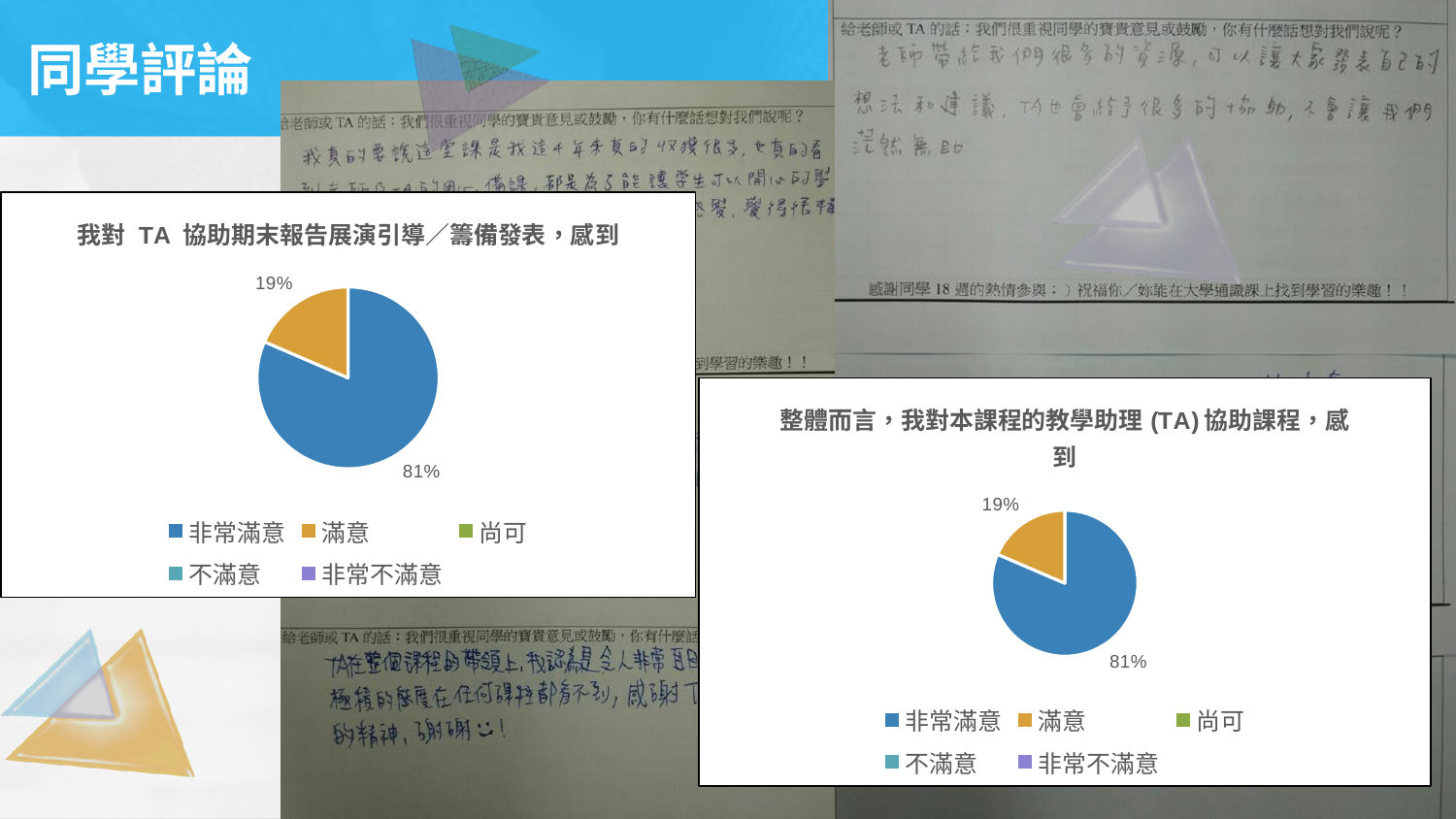
In the chart titled 「整體而言，我對本課程的教學助理 (TA) 協助課程，感到」, what share of the pie is 滿意? 19% In the chart titled 「整體而言，我對本課程的教學助理 (TA) 協助課程，感到」, what share of the pie is 非常滿意? 81% What kind of chart is the one on the right of the slide, titled 「整體而言，我對本課程的教學助理 (TA) 協助課程，感到」? Pie chart In the chart titled 「我對 TA 協助期末報告展演引導／籌備發表，感到」, what share of the pie is 非常滿意? 81% What kind of chart is the one on the left of the slide, titled 「我對 TA 協助期末報告展演引導／籌備發表，感到」? Pie chart In the chart titled 「整體而言，我對本課程的教學助理 (TA) 協助課程，感到」, which is larger, the 非常滿意 slice or the 滿意 slice? 非常滿意 In the chart titled 「整體而言，我對本課程的教學助理 (TA) 協助課程，感到」, what colour is the 滿意 slice? Orange How many entries does the legend list in the chart titled 「我對 TA 協助期末報告展演引導／籌備發表，感到」? 5 In the chart titled 「我對 TA 協助期末報告展演引導／籌備發表，感到」, which category has the largest slice? 非常滿意 In the chart titled 「整體而言，我對本課程的教學助理 (TA) 協助課程，感到」, which category has the largest slice? 非常滿意 In the chart titled 「我對 TA 協助期末報告展演引導／籌備發表，感到」, what is the difference in percentage points between the 非常滿意 slice and the 滿意 slice? 62 percentage points